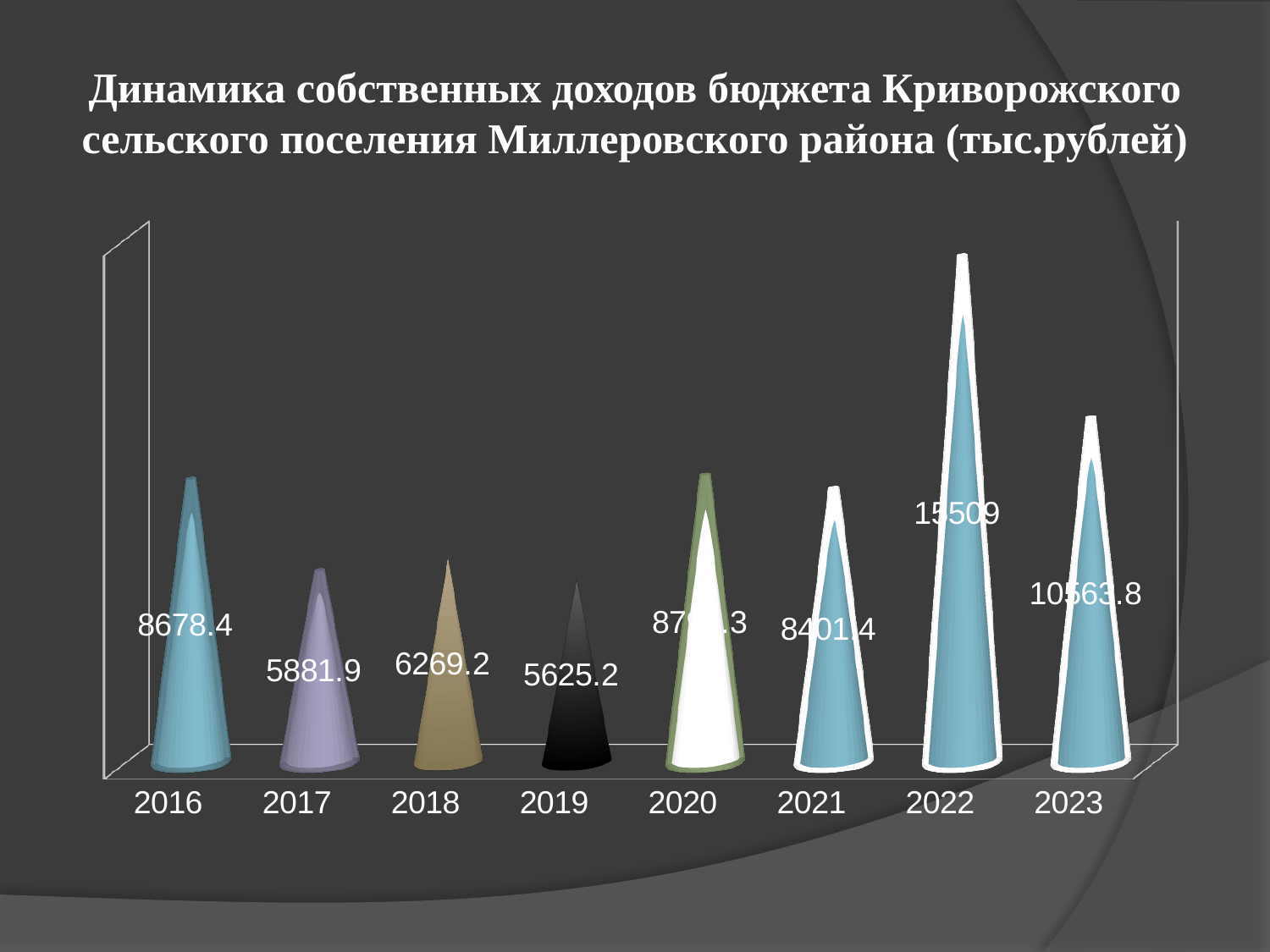
What is the value for 2023? 10563.8 What is the difference between the values for 2022 and 2023? 4945.2 Which year has the highest value? 2022 What is the value for 2019? 5625.2 How many years are shown on the x axis? 8 Which is larger, the value for 2017 or the value for 2018? 2018 Does the value rise or fall from 2021 to 2022? rise Which year has the lowest value? 2019 What kind of chart is shown on the slide? bar chart What is the value for 2016? 8678.4 What is the difference between the values for 2018 and 2019? 644 What is the value for 2022? 15509